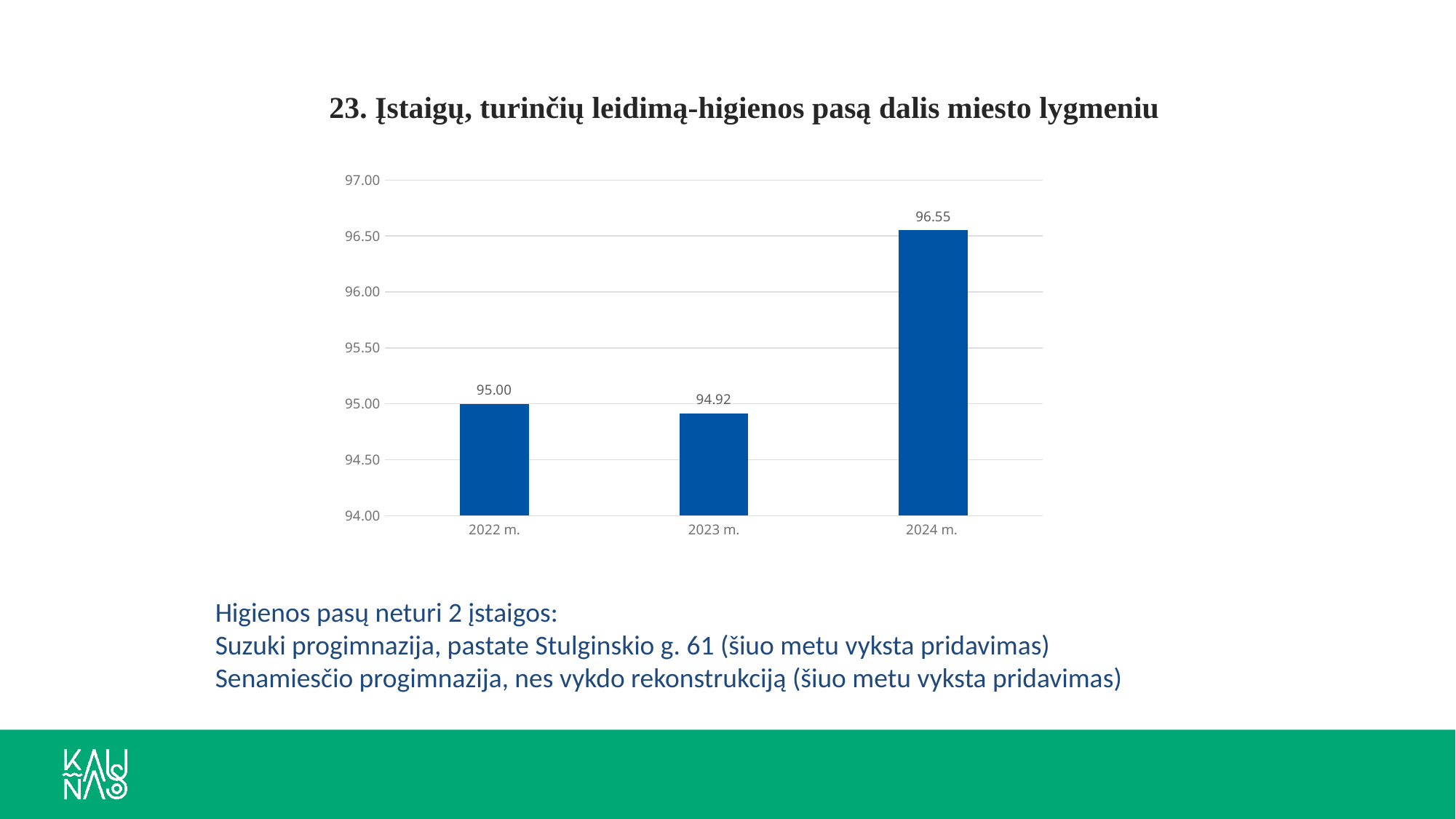
What is the difference between the values for 2022 m. and 2023 m.? 0.08 What is the difference between the values for 2024 m. and 2023 m.? 1.63 What kind of chart is shown on the slide? bar chart What is the value for 2023 m.? 94.92 Which year has the lowest value? 2023 m. Is the value for 2024 m. greater or less than 96.00? greater How many years are shown on the chart? 3 What is the value for 2024 m.? 96.55 Which year has the highest value? 2024 m. Which is larger, the value for 2022 m. or the value for 2024 m.? 2024 m. What is the value for 2022 m.? 95.00 What is the title of the chart? 23. Įstaigų, turinčių leidimą-higienos pasą dalis miesto lygmeniu